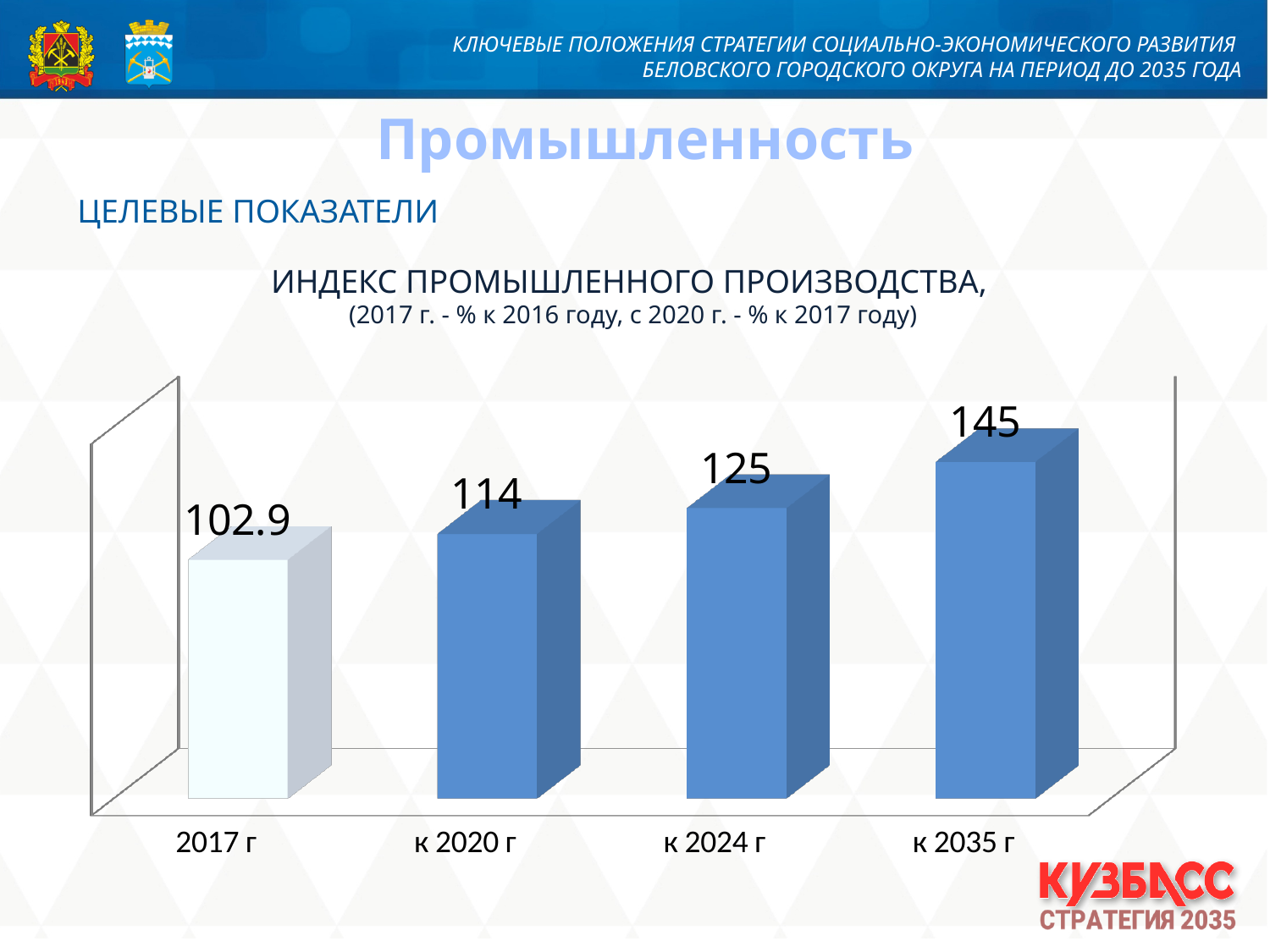
What is the difference between the values for к 2020 г and 2017 г? 11.1 What is the difference between the values for к 2035 г and к 2024 г? 20 How many categories are shown on the chart? 4 Do the values rise or fall from 2017 г to к 2035 г? rise What kind of chart is shown? bar chart Which category has the lowest value? 2017 г What is the value for 2017 г? 102.9 What is the value for к 2035 г? 145 What is the value for к 2020 г? 114 What is the value for к 2024 г? 125 Which is larger, the value for к 2024 г or the value for к 2020 г? к 2024 г Which category has the highest value? к 2035 г